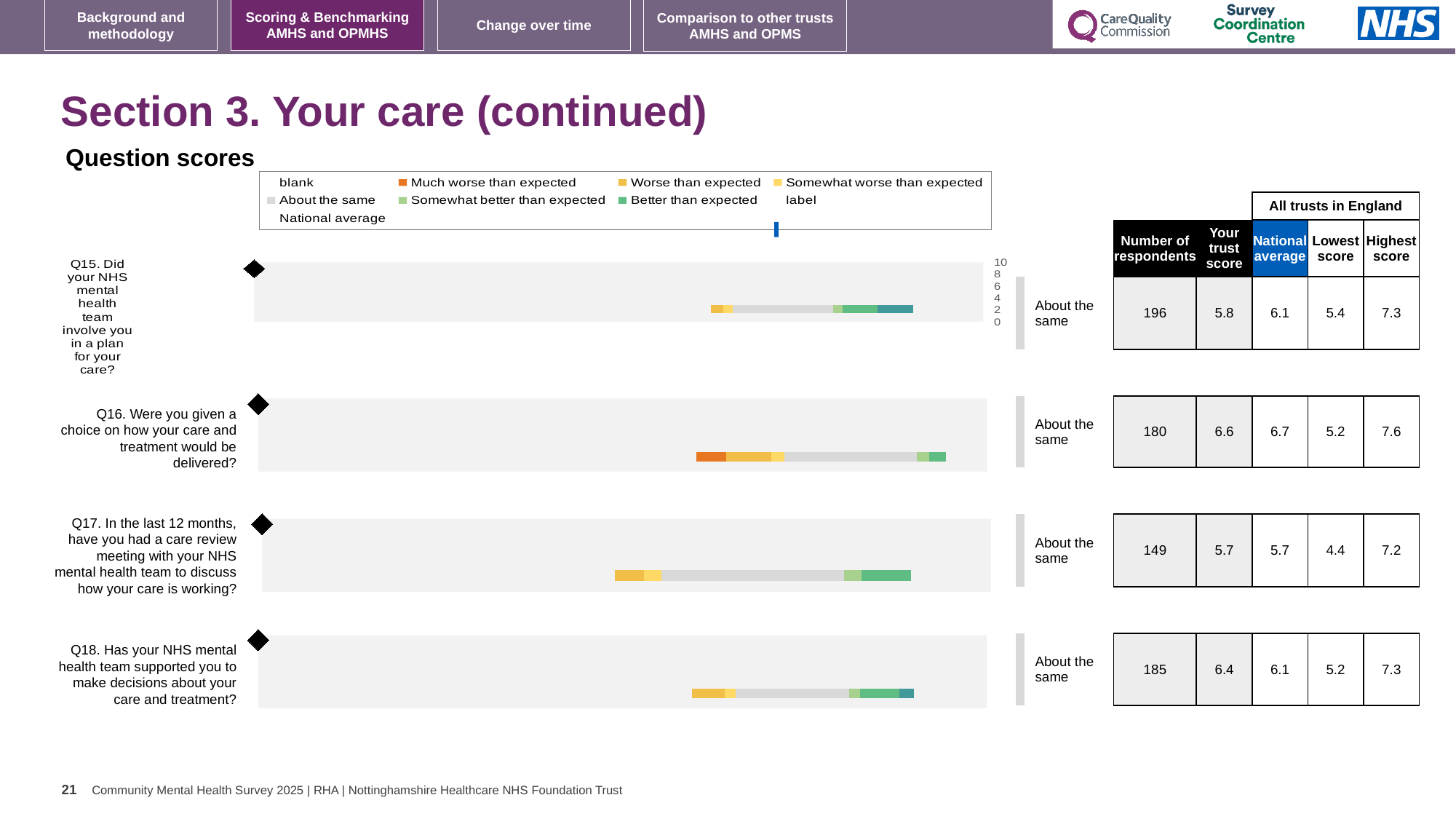
What kind of chart is used to show the question scores for Q15 to Q18? bar chart What is the national average for Q17 (care review meeting in the last 12 months)? 5.7 For Q15, which is larger: the trust score or the national average? national average What is the highest score among all trusts in England for Q18? 7.3 What is the number of respondents for Q15? 196 Which question has the highest number of respondents? Q15 For Q18, which is larger: the trust score or the national average? trust score What benchmark category label is shown next to the bar for Q17? About the same What is the trust score for Q16 (choice on how care and treatment would be delivered)? 6.6 What is the difference between the highest score and the lowest score for Q16? 2.4 How many questions (Q15 to Q18) have a score bar plotted on the slide? 4 Which question has the lowest 'Lowest score' among all trusts in England? Q17